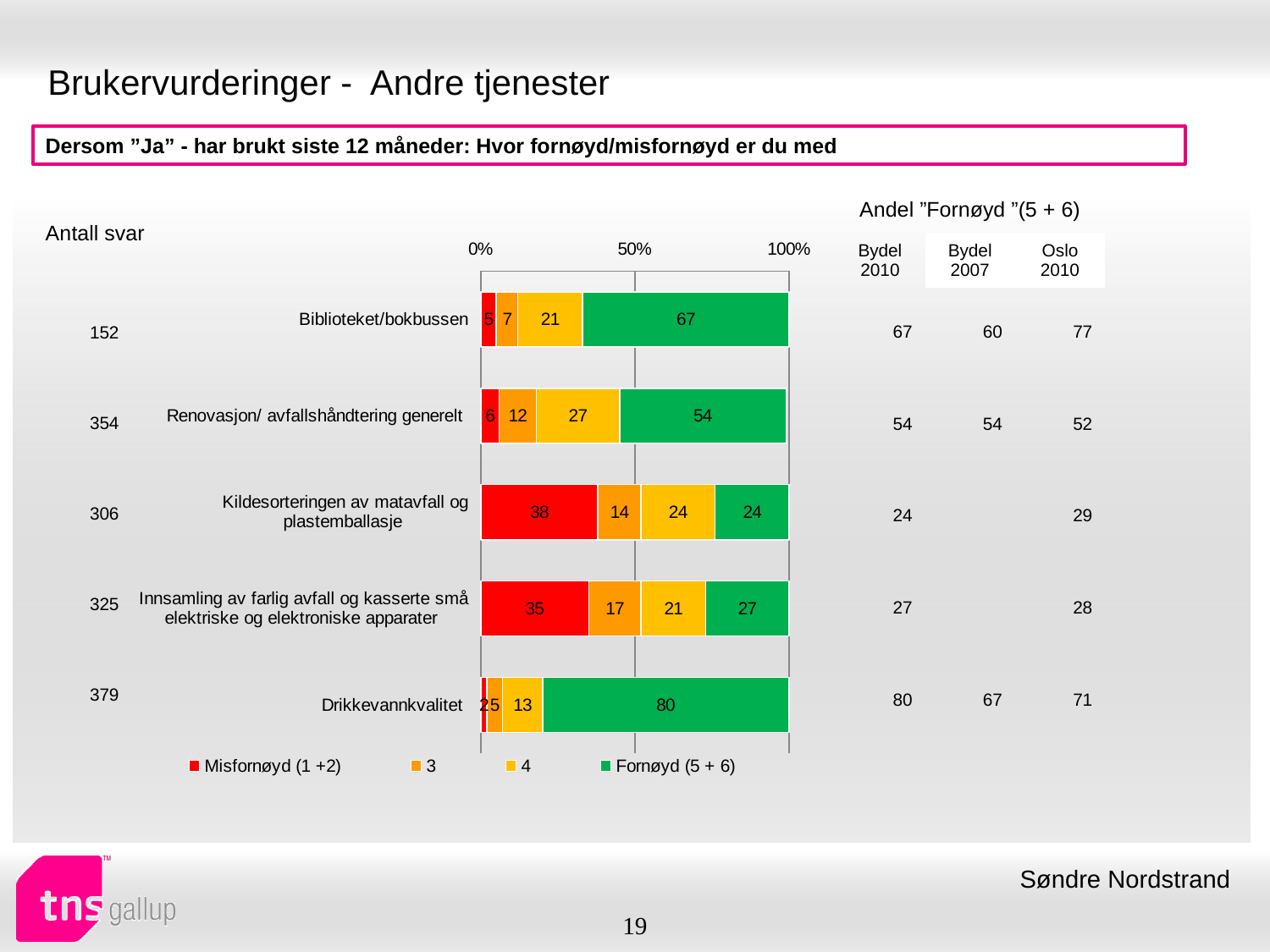
How many categories are shown in the chart? 5 Which has the larger Misfornøyd (1 +2) value: Kildesorteringen av matavfall og plastemballasje or Innsamling av farlig avfall og kasserte små elektriske og elektroniske apparater? Kildesorteringen av matavfall og plastemballasje What is the value of the Misfornøyd (1 +2) segment for Kildesorteringen av matavfall og plastemballasje? 38 What does the green segment of the bars represent according to the legend? Fornøyd (5 + 6) Which category has the highest Fornøyd (5 + 6) value? Drikkevannkvalitet What kind of chart is shown on the slide? Stacked bar chart What is the difference between the Fornøyd (5 + 6) values for Biblioteket/bokbussen and Renovasjon/ avfallshåndtering generelt? 13 What is the value of the Fornøyd (5 + 6) segment for Drikkevannkvalitet? 80 How many series does the legend list? 4 What is the value of the '4' segment for Renovasjon/ avfallshåndtering generelt? 27 What is the value of the '3' segment for Innsamling av farlig avfall og kasserte små elektriske og elektroniske apparater? 17 Which category has the lowest Fornøyd (5 + 6) value? Kildesorteringen av matavfall og plastemballasje